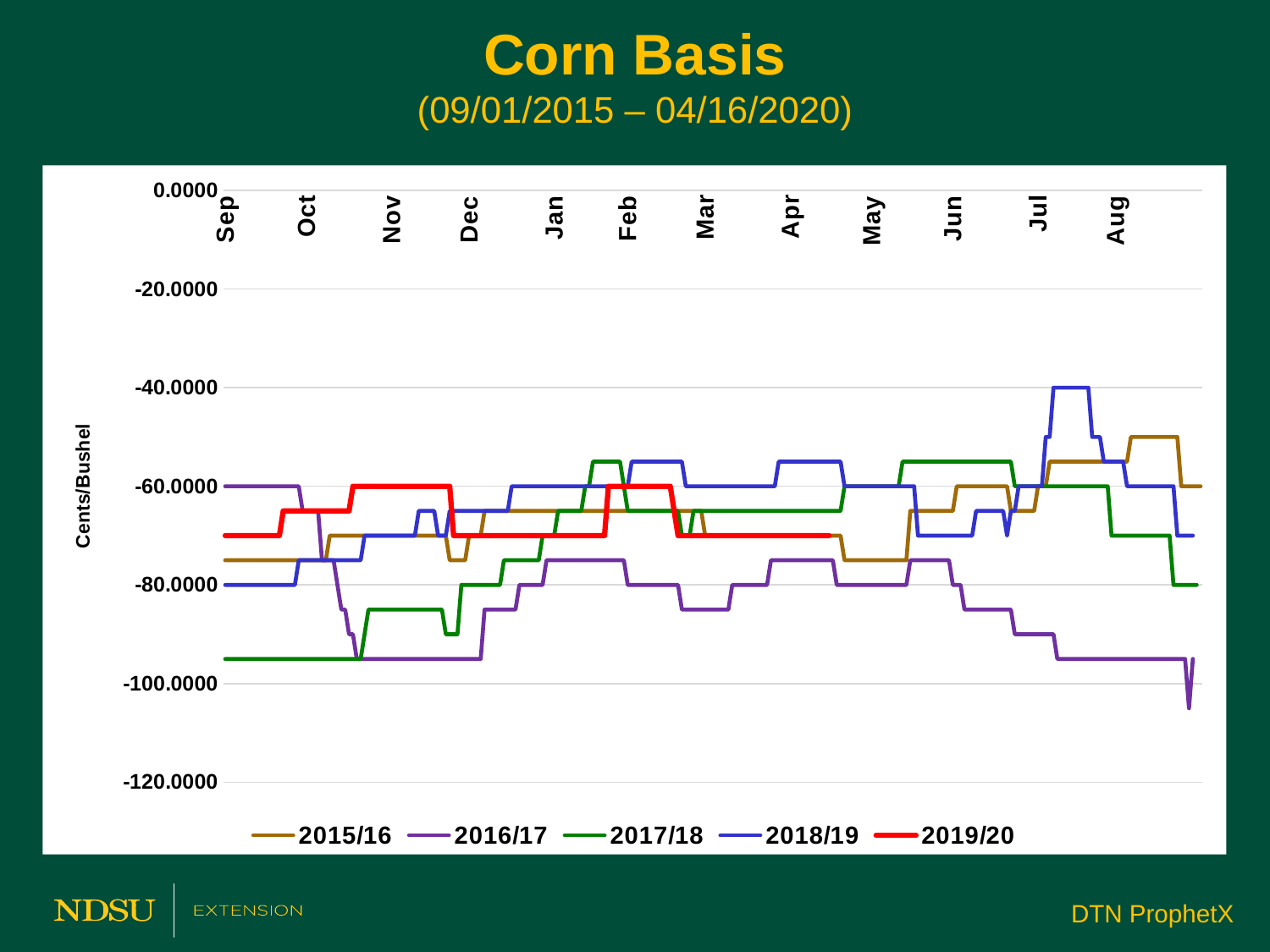
Which series reaches the lowest value on the chart? 2016/17 What is the peak value of the 2018/19 series in Jul? -40.0000 Which series reaches the highest value on the chart? 2018/19 What is the value of the 2018/19 series at the start of Sep? -80.0000 Is the value of the 2016/17 series in Aug greater or less than -80? less Is the value of the 2019/20 series in Apr greater or less than -60? less What is the label on the y axis? Cents/Bushel How many months are labelled along the x axis? 12 What kind of chart is shown on the slide? line chart In Sep, which series has the larger value, 2016/17 or 2017/18? 2016/17 Which series is drawn in red? 2019/20 How many series does the legend list? 5